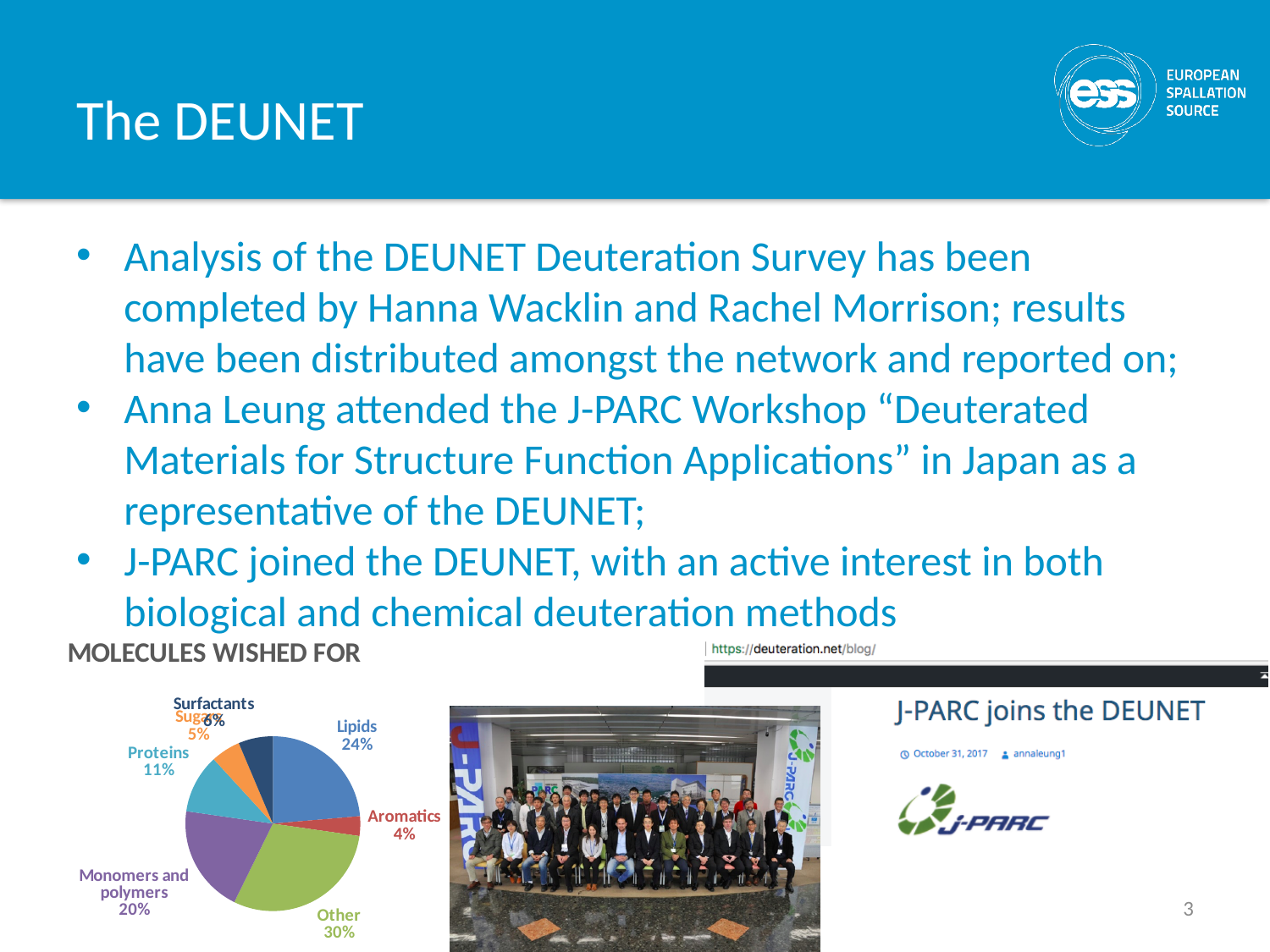
Which category has the largest share in the "MOLECULES WISHED FOR" pie chart? Other Which category has the smallest share in the "MOLECULES WISHED FOR" pie chart? Aromatics What is the value shown for Monomers and polymers in the "MOLECULES WISHED FOR" pie chart? 20% How many slices does the "MOLECULES WISHED FOR" pie chart have? 7 What is the value shown for Aromatics in the "MOLECULES WISHED FOR" pie chart? 4% What percentage of the "MOLECULES WISHED FOR" pie chart is Lipids? 24% What is the title of the pie chart on the slide? MOLECULES WISHED FOR What is the value shown for Proteins in the "MOLECULES WISHED FOR" pie chart? 11% In the "MOLECULES WISHED FOR" pie chart, how many percentage points larger is Other than Lipids? 6 What is the value shown for Other in the "MOLECULES WISHED FOR" pie chart? 30% In the "MOLECULES WISHED FOR" pie chart, which is larger: Lipids or Monomers and polymers? Lipids What kind of chart is shown under the heading "MOLECULES WISHED FOR"? pie chart